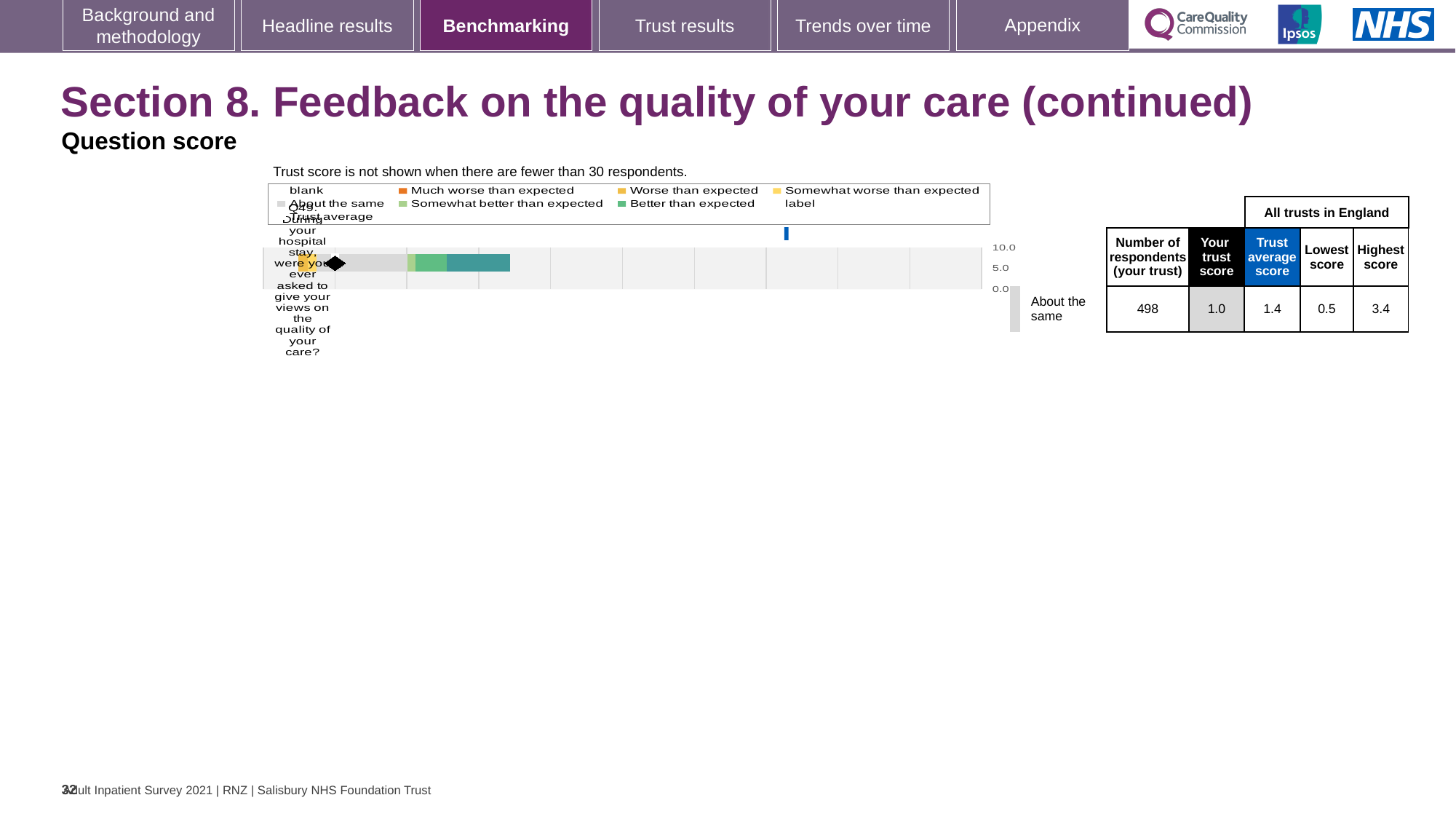
What is your trust score for Q49? 1.0 Is your trust score for Q49 greater or less than 5.0? less How is your trust's result for Q49 categorised relative to expectations? About the same What is the number of respondents for your trust for Q49? 498 What is the highest score among all trusts in England for Q49? 3.4 What kind of chart is shown on the slide? bar chart Which is larger for Q49: your trust score or the trust average score? Trust average score What is the trust average score for Q49 across all trusts in England? 1.4 How many survey questions are plotted in the chart? 1 What is the lowest score among all trusts in England for Q49? 0.5 What is the difference between the highest and lowest scores for Q49 across all trusts in England? 2.9 Which legend entry is shown with an orange marker? Much worse than expected